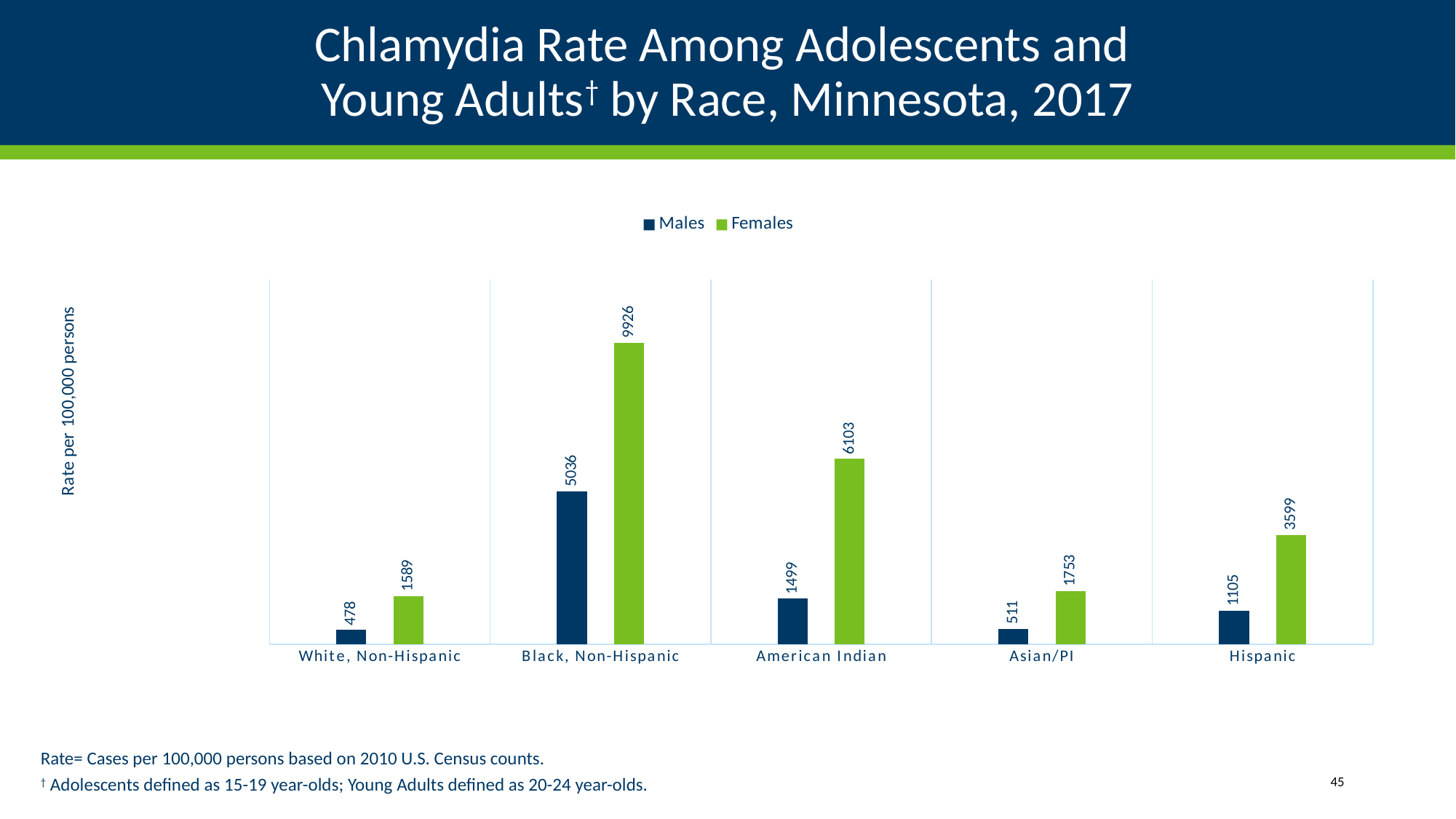
What is the difference between the Females and Males rates in the Black, Non-Hispanic group? 4890 How many series does the legend list? 2 What is the chlamydia rate for Females in the Black, Non-Hispanic group? 9926 How many race groups are shown on the x axis? 5 What is the chlamydia rate for Females in the Hispanic group? 3599 Which race group has the lowest Males rate? White, Non-Hispanic What kind of chart is shown on the slide? Bar chart Which is larger, the Males rate for Hispanic or the Males rate for American Indian? American Indian What is the difference between the Females rates for American Indian and Hispanic groups? 2504 What is the chlamydia rate for Males in the Asian/PI group? 511 Which race group has the highest Females rate? Black, Non-Hispanic What is the chlamydia rate for Males in the American Indian group? 1499